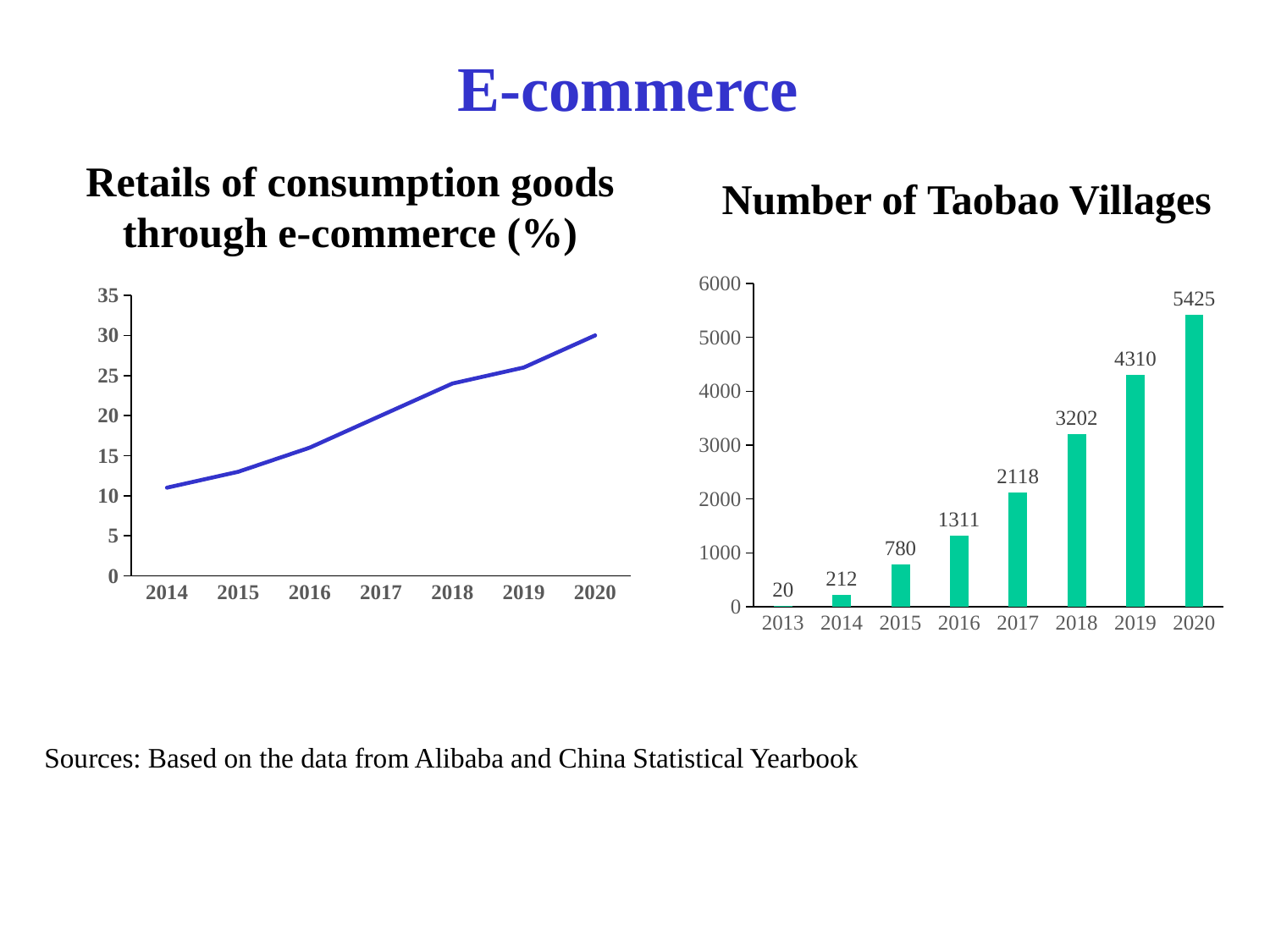
In the 'Retails of consumption goods through e-commerce (%)' chart, is the value for 2020 greater or less than 25? greater In the 'Number of Taobao Villages' chart, which year has the lowest value? 2013 In the 'Number of Taobao Villages' chart, what is the value for 2015? 780 In the 'Retails of consumption goods through e-commerce (%)' chart, do the values rise or fall from 2014 to 2020? rise What kind of chart is the 'Number of Taobao Villages' chart? bar chart In the 'Retails of consumption goods through e-commerce (%)' chart, is the value for 2014 greater or less than 15? less In the 'Number of Taobao Villages' chart, which year has the highest value? 2020 What kind of chart is the 'Retails of consumption goods through e-commerce (%)' chart? line chart In the 'Number of Taobao Villages' chart, which is larger, the value for 2016 or the value for 2017? 2017 In the 'Number of Taobao Villages' chart, what is the value for 2018? 3202 In the 'Number of Taobao Villages' chart, what is the difference between the values for 2020 and 2019? 1115 In the 'Number of Taobao Villages' chart, how many years are shown on the x axis? 8